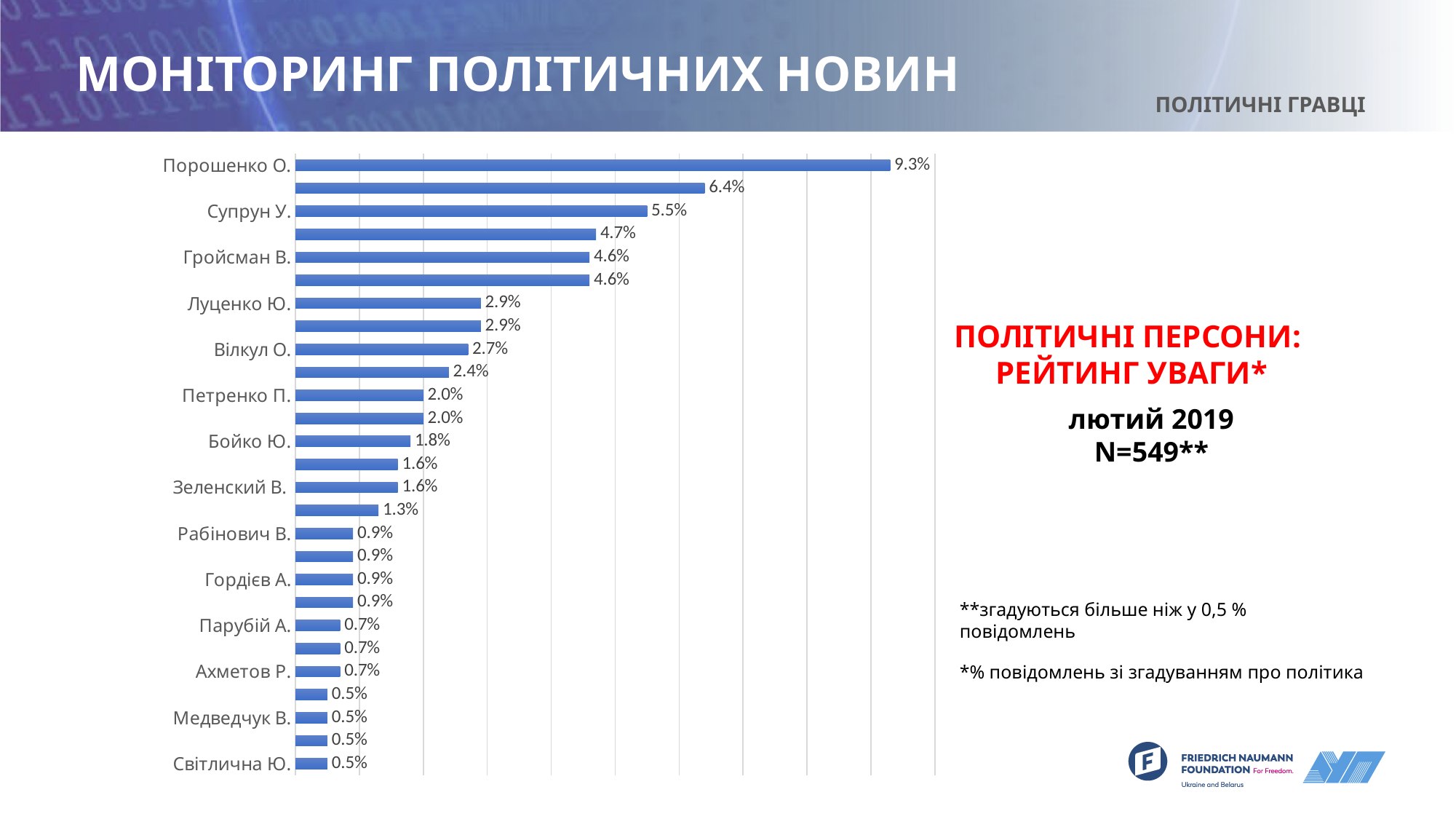
What is the value for Зеленский В.? 1.6% What is the difference between the values for Гройсман В. and Луценко Ю.? 1.7% What is the difference between the values for Порошенко О. and Супрун У.? 3.8% Which is larger, the value for Бойко Ю. or the value for Рабінович В.? Бойко Ю. What is the value for Порошенко О.? 9.3% What is the value for Супрун У.? 5.5% What is the value for Гройсман В.? 4.6% Which labelled person has the highest value? Порошенко О. What kind of chart is shown on the slide? bar chart Which is larger, the value for Вілкул О. or the value for Петренко П.? Вілкул О. What is the sample size (N) stated next to the chart? N=549 What is the value for Вілкул О.? 2.7%